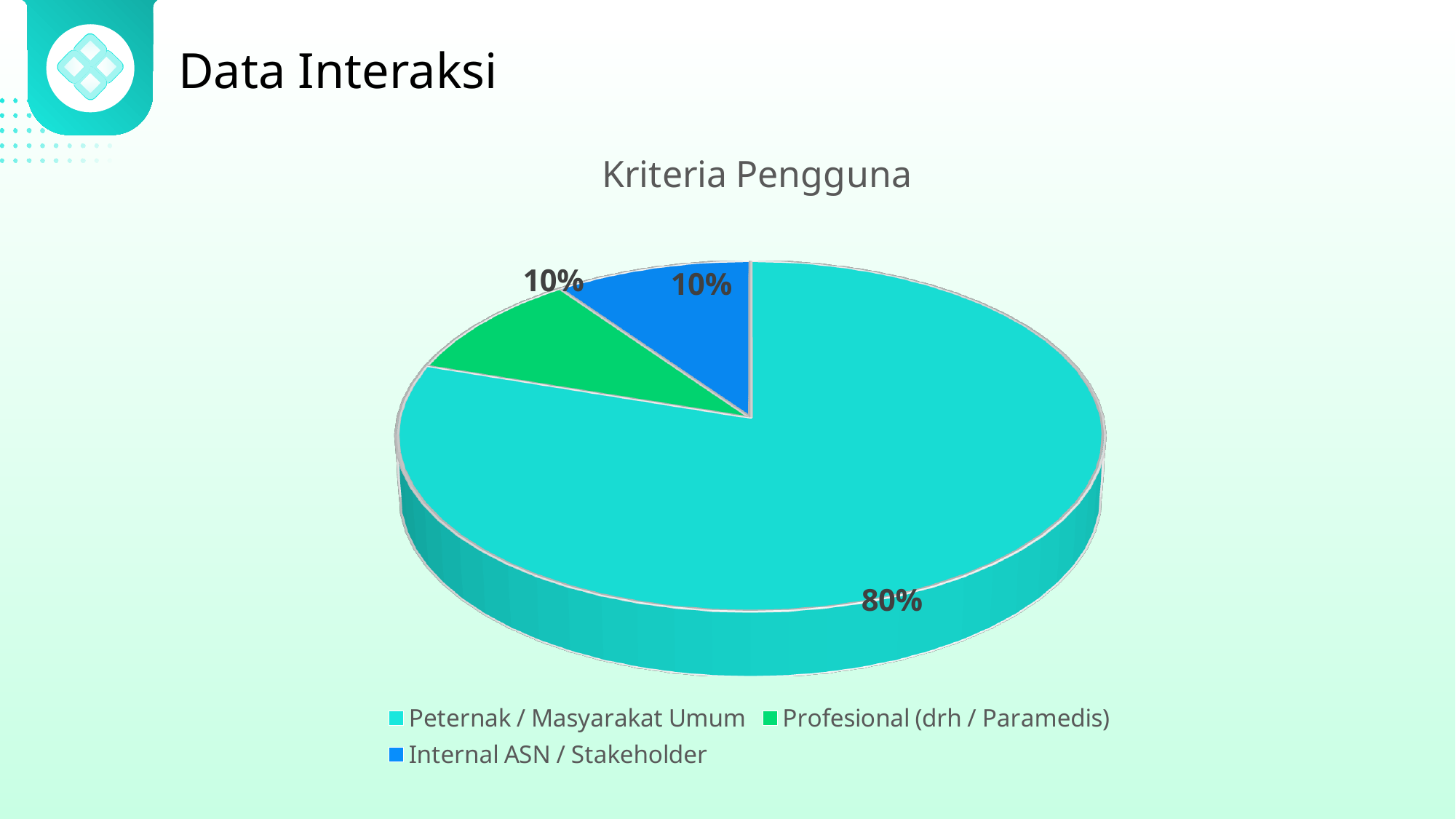
How many slices does the pie chart have? 3 How many entries does the legend list? 3 What is the difference between the share for Peternak / Masyarakat Umum and the share for Internal ASN / Stakeholder? 70% What share of the pie does Internal ASN / Stakeholder have? 10% What is the combined share of Profesional (drh / Paramedis) and Internal ASN / Stakeholder? 20% What is the title of the chart? Kriteria Pengguna What kind of chart is shown on the slide? Pie chart Which is larger, the share for Peternak / Masyarakat Umum or the share for Profesional (drh / Paramedis)? Peternak / Masyarakat Umum Which legend entry is shown in blue? Internal ASN / Stakeholder What share of the pie does Profesional (drh / Paramedis) have? 10% What share of the pie does Peternak / Masyarakat Umum have? 80% Which category has the largest slice of the pie? Peternak / Masyarakat Umum